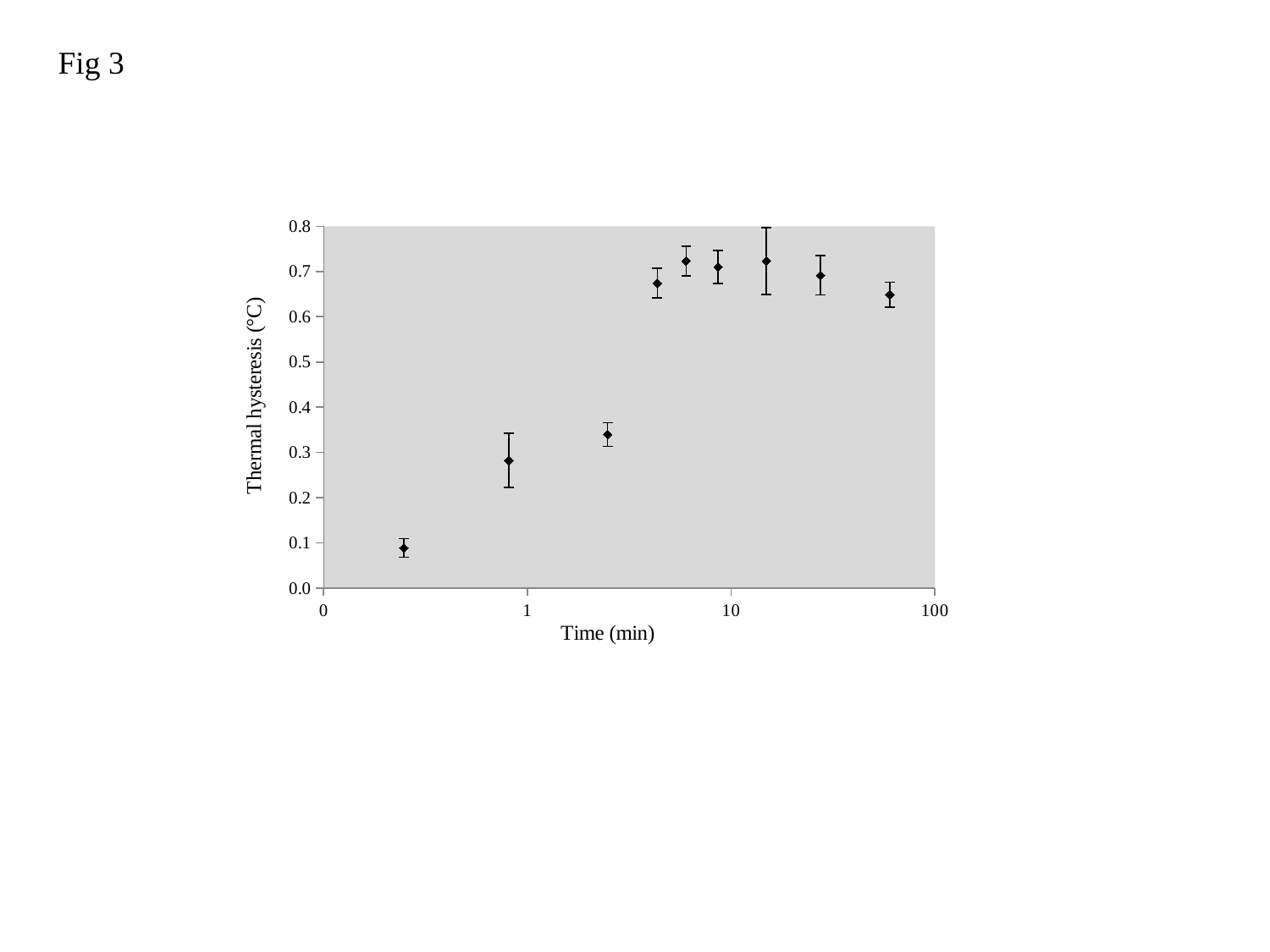
What kind of chart is shown on the slide? scatter chart Is the thermal hysteresis value of the fourth data point from the left greater or less than 0.5? greater Is the thermal hysteresis value of the leftmost data point greater or less than 0.2? less Which has the larger thermal hysteresis value, the leftmost data point or the rightmost data point? the rightmost point Which data point has the lowest thermal hysteresis value? the leftmost point What is the label of the x axis? Time (min) Is the thermal hysteresis value of the rightmost data point greater or less than 0.6? greater Do the thermal hysteresis values generally rise or fall as time increases from the leftmost point to the points around 10 minutes? rise What is the label of the y axis? Thermal hysteresis (°C) How many data points are plotted on the chart? 9 Which has the larger thermal hysteresis value, the third data point from the left or the fourth data point from the left? the fourth point from the left